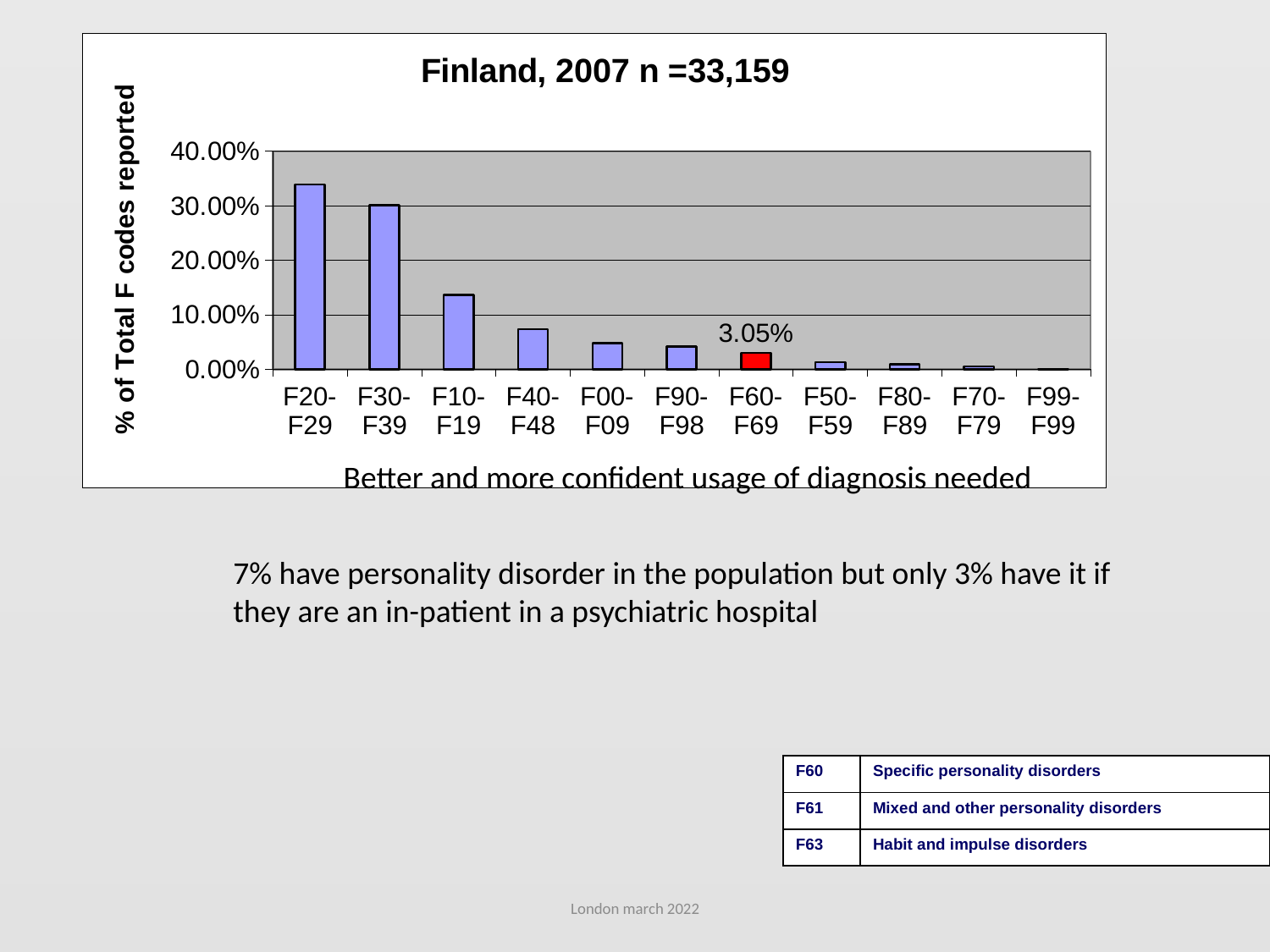
Is the value for F40-F48 greater or less than 10.00%? less What type of chart is shown on the slide? bar chart Which category has the lowest value? F99-F99 How many categories are shown on the x axis? 11 Do the values rise or fall from left to right along the x axis? fall What is the label of the y axis? % of Total F codes reported Is the value for F10-F19 greater or less than 10.00%? greater What is the value for F60-F69? 3.05% Is the value for F20-F29 greater or less than 30.00%? greater What is the title of the chart? Finland, 2007 n =33,159 Which category has the highest value? F20-F29 Which is larger, the value for F30-F39 or the value for F10-F19? F30-F39